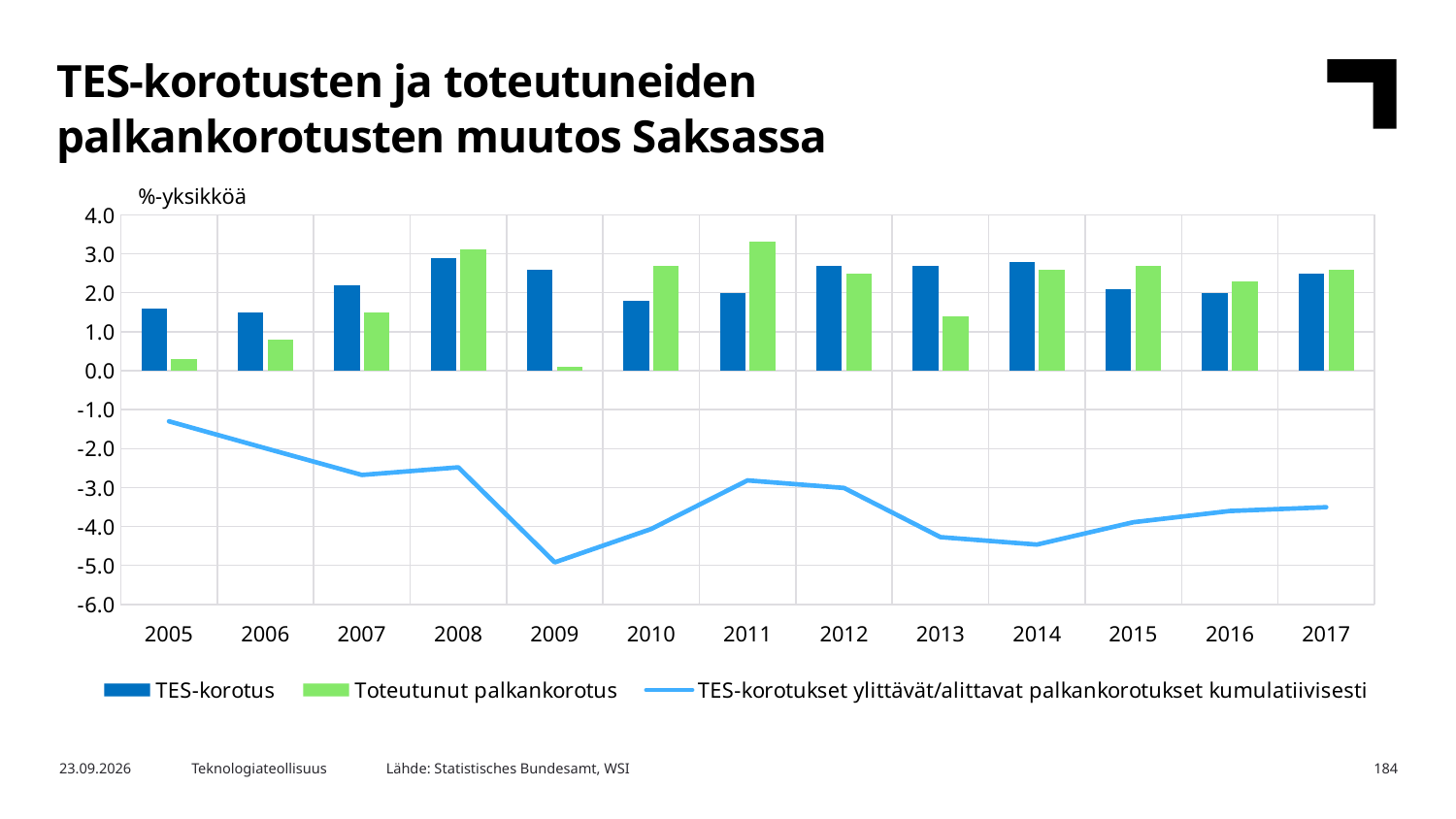
In 2005, which is larger: TES-korotus or Toteutunut palkankorotus? TES-korotus What kind of chart is shown on the slide? A combined bar and line chart Is the value of the cumulative line in 2009 greater or less than -4.0? less In 2011, which is larger: TES-korotus or Toteutunut palkankorotus? Toteutunut palkankorotus Is the Toteutunut palkankorotus value for 2005 greater or less than 1.0? less How many years are shown on the x axis? 13 How many series does the legend list? 3 What unit label is shown above the vertical axis? %-yksikköä Is the TES-korotus value for 2008 greater or less than 2.0? greater Which year has the lowest value for Toteutunut palkankorotus? 2009 In which year does the line TES-korotukset ylittävät/alittavat palkankorotukset kumulatiivisesti reach its lowest point? 2009 Does the cumulative line rise or fall from 2014 to 2017? rise